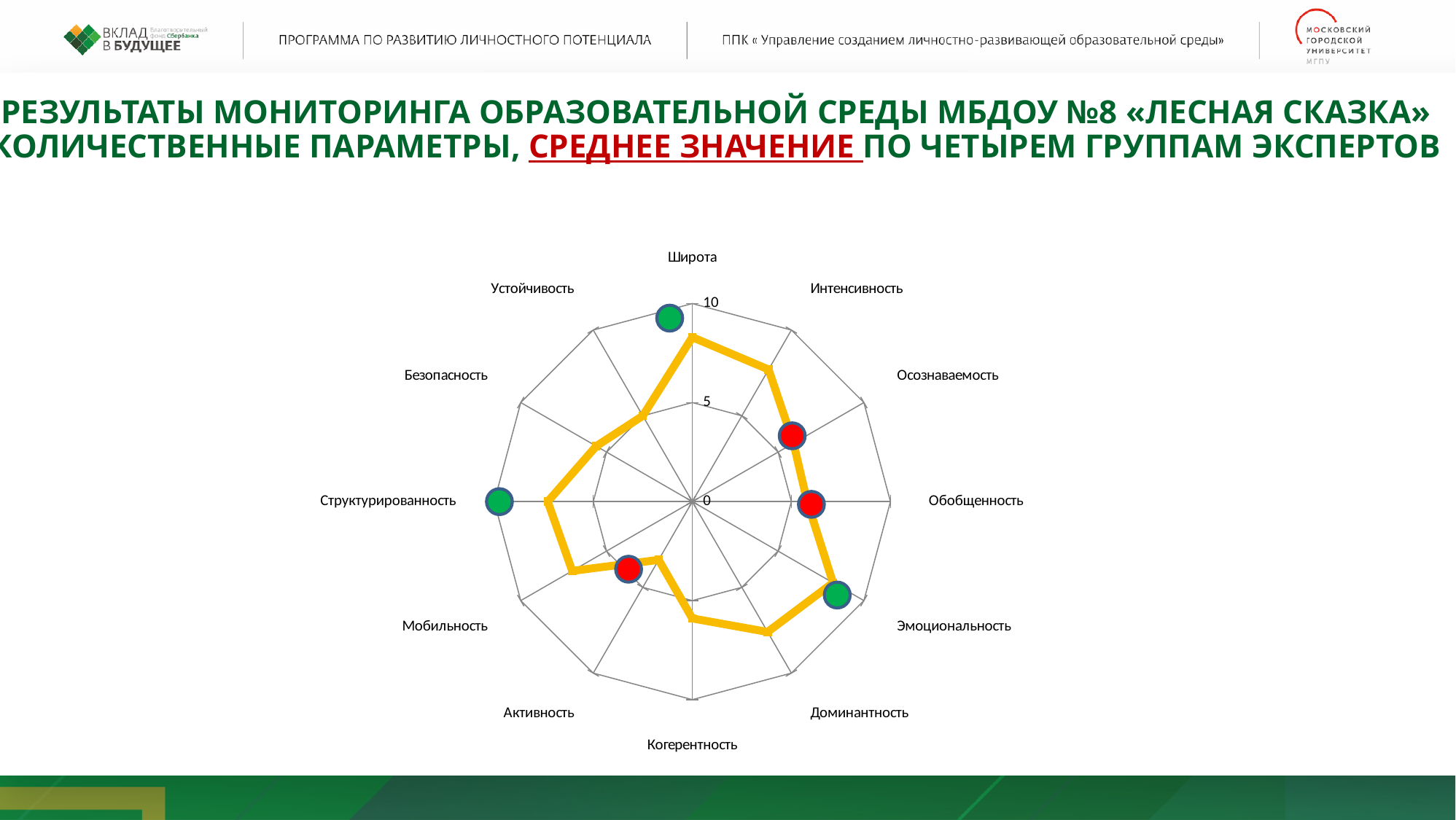
How many categories (parameters) are plotted on the radar chart? 12 Is the value for Структурированность greater or less than 5? greater What colour is the data line on the radar chart? Yellow Is the value for Эмоциональность greater or less than 5? greater Is the value for Интенсивность greater or less than 5? greater What is the maximum value shown on the radar chart's axis scale? 10 Which is larger, the value for Структурированность or the value for Когерентность? Структурированность What kind of chart is shown on the slide? Radar chart Which is larger, the value for Широта or the value for Активность? Широта Which category has the lowest value on the radar chart? Активность